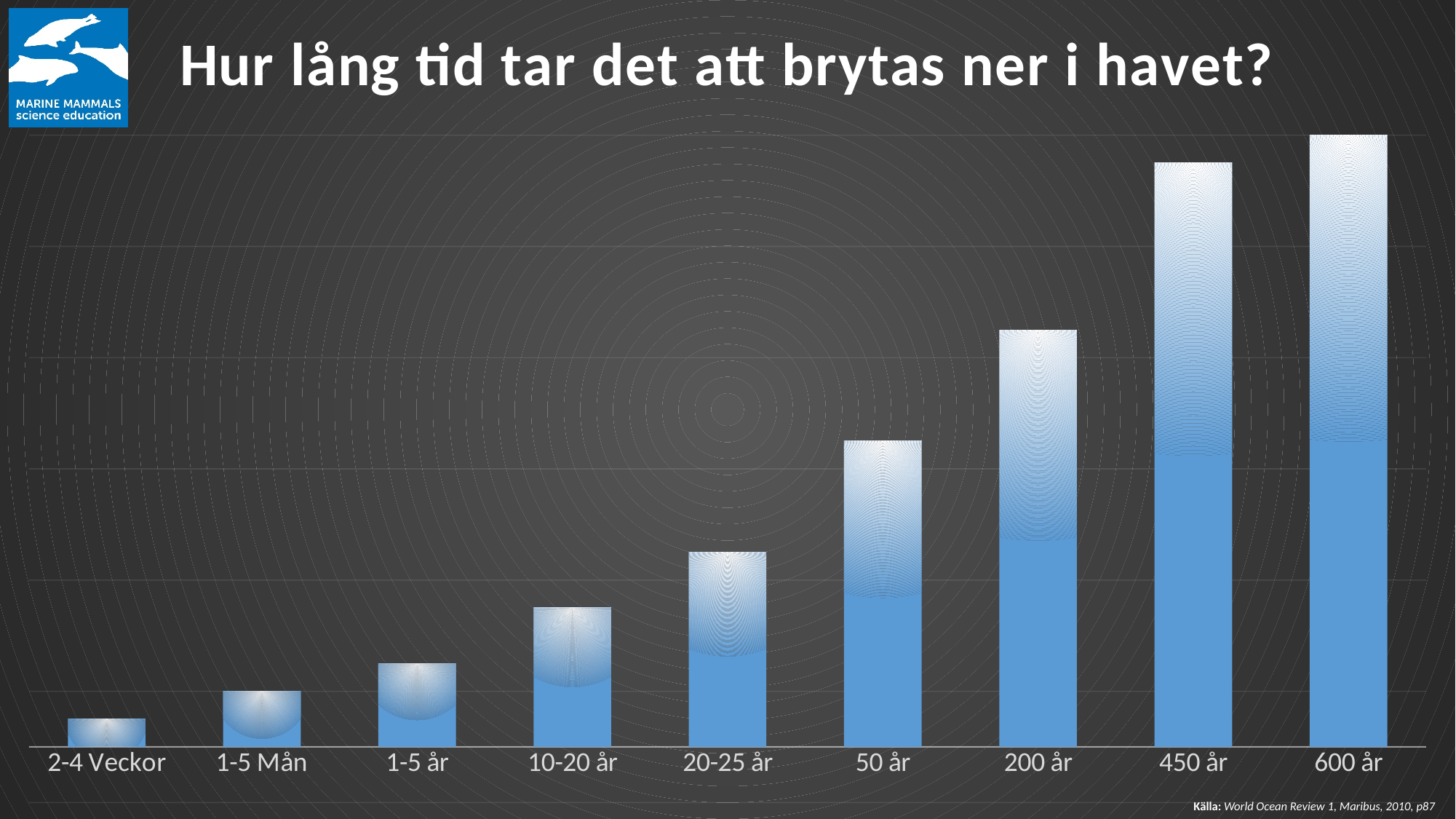
Which category has the tallest bar? 600 år Which bar is shorter, 50 år or 20-25 år? 20-25 år Which category has the shortest bar? 2-4 Veckor Do the bar heights rise or fall from left to right along the x axis? rise What is the title of the chart? Hur lång tid tar det att brytas ner i havet? What kind of chart is shown on the slide? bar chart Which bar is taller, 450 år or 200 år? 450 år How many bars are shown in the chart? 9 Which bar is taller, 1-5 Mån or 10-20 år? 10-20 år What is the label of the first category on the x axis? 2-4 Veckor